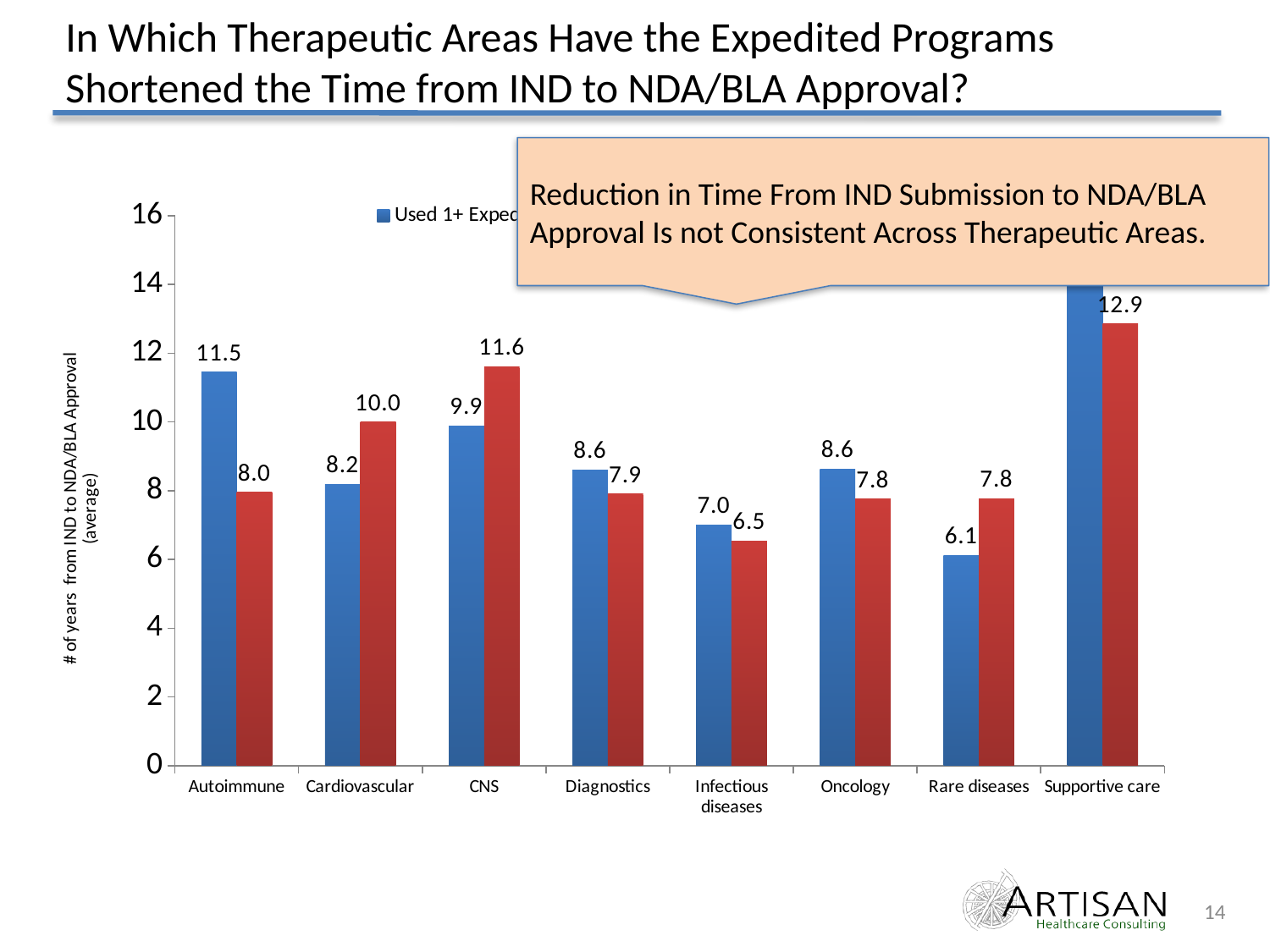
What kind of chart is shown on the slide? bar chart What is the difference between the red and blue bars for Rare diseases? 1.7 For Cardiovascular, which bar is larger, the blue or the red? red How many therapeutic areas are shown on the x axis? 8 Which therapeutic area has the lowest blue bar? Rare diseases Which therapeutic area has the highest red bar? Supportive care What is the value of the blue bar for Autoimmune? 11.5 What is the difference between the blue and red bars for Autoimmune? 3.5 Is the value of the blue bar for Supportive care greater or less than 12? greater What is the value of the red bar for Supportive care? 12.9 For Diagnostics, which bar is larger, the blue or the red? blue What is the value of the red bar for CNS? 11.6